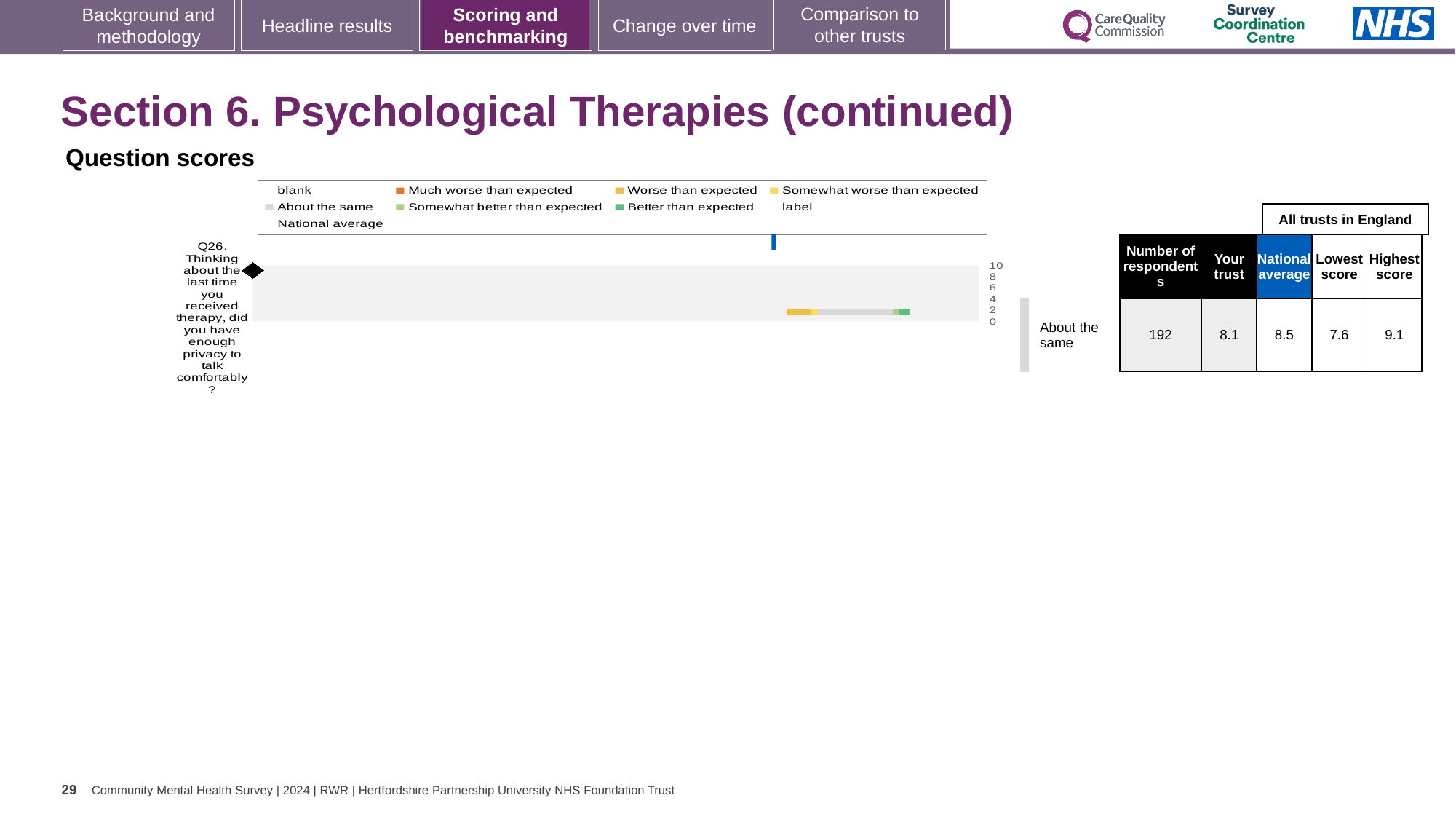
Which question number is plotted on the chart? Q26 What is the 'Your trust' score for Q26? 8.1 Which is larger for Q26, the trust's score or the national average? national average What is the highest score among all trusts in England for Q26? 9.1 What is the difference between the highest and lowest scores for Q26? 1.5 How many survey questions are plotted on the chart? 1 How many respondents answered Q26? 192 What kind of chart is used to show the Q26 question score? bar chart What is the lowest score among all trusts in England for Q26? 7.6 What benchmarking category is the trust's Q26 score placed in? About the same What is the national average score for Q26? 8.5 What is the maximum value shown on the score axis of the chart? 10